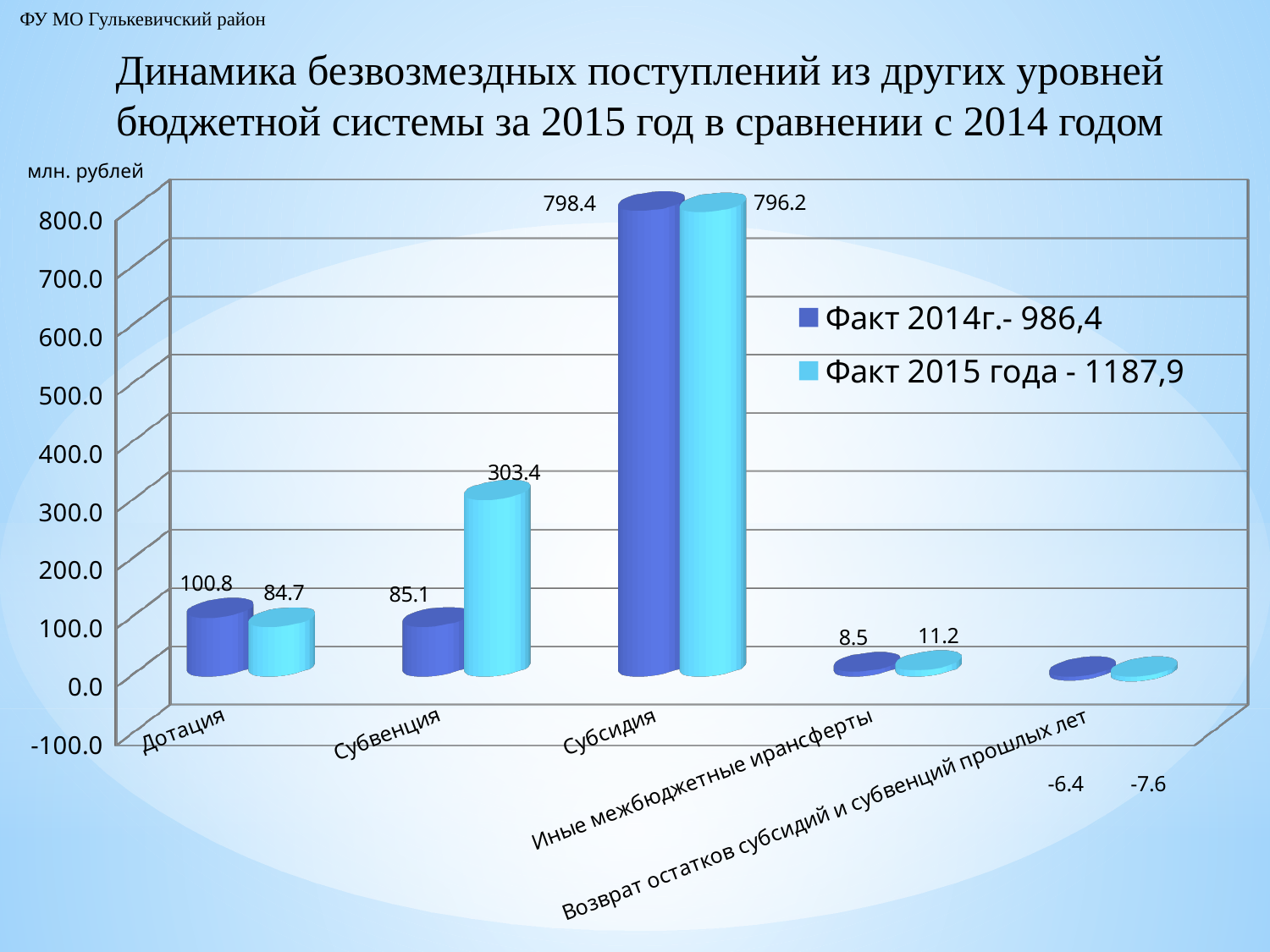
What is the value for Возврат остатков субсидий и субвенций прошлых лет in the Факт 2014г. series? -6.4 Which category has the highest value in the Факт 2014г. series? Субсидия Which category has the lowest value in the Факт 2015 года series? Возврат остатков субсидий и субвенций прошлых лет What is the difference between the Факт 2014г. and Факт 2015 года values for Дотация? 16.1 What kind of chart is shown on the slide? Bar chart What is the difference between the Факт 2015 года and Факт 2014г. values for Субвенция? 218.3 What is the value for Субсидия in the Факт 2015 года series? 796.2 How many series does the legend list? 2 How many categories are shown on the x axis? 5 What is the value for Субвенция in the Факт 2015 года series? 303.4 For Иные межбюджетные трансферты, which series has the larger value, Факт 2014г. or Факт 2015 года? Факт 2015 года What is the value for Дотация in the Факт 2014г. series? 100.8